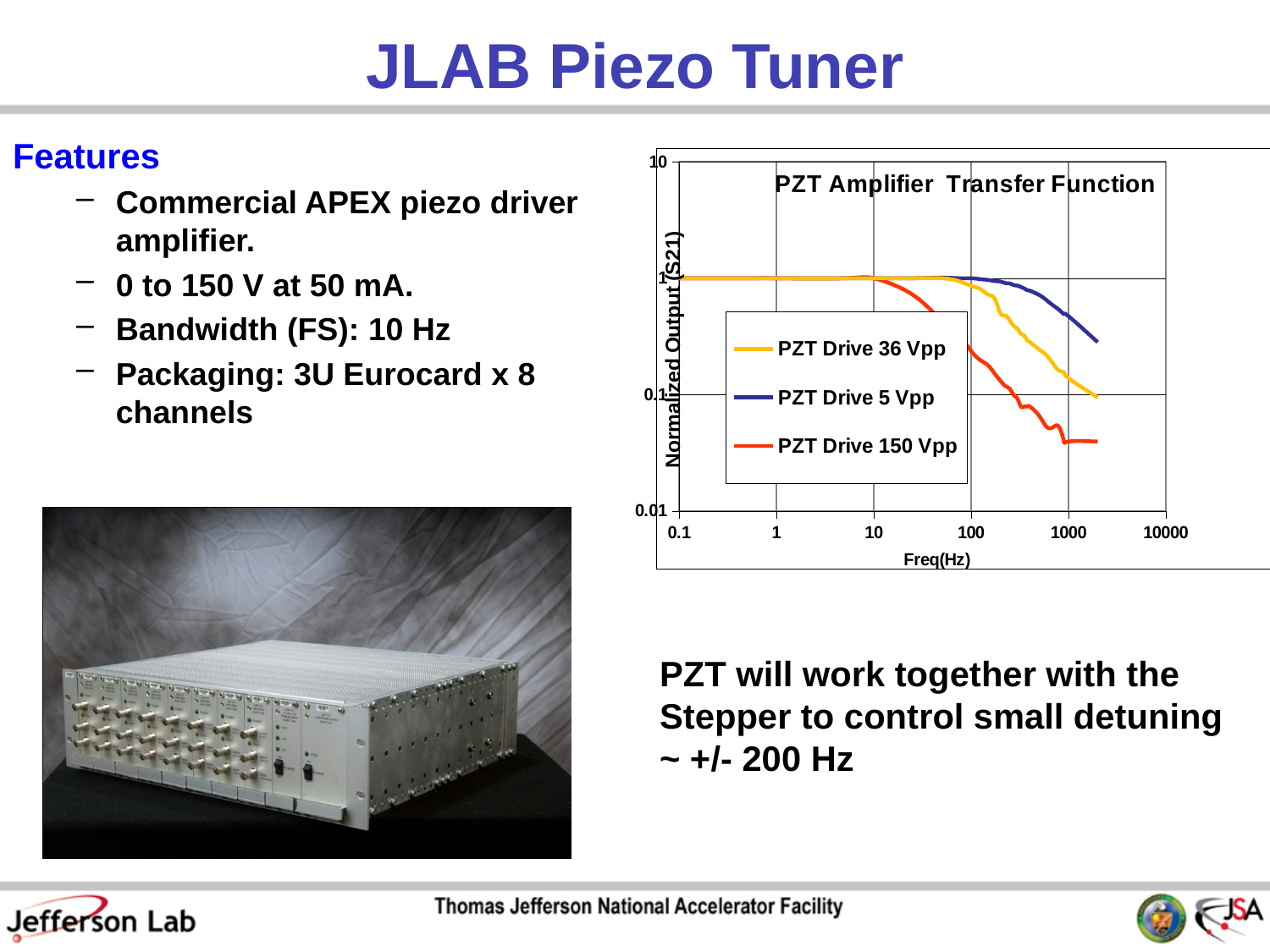
In the PZT Amplifier Transfer Function chart, which series has the higher normalized output at 1000 Hz, PZT Drive 36 Vpp or PZT Drive 150 Vpp? PZT Drive 36 Vpp In the PZT Amplifier Transfer Function chart, which series has the lowest normalized output at 1000 Hz? PZT Drive 150 Vpp What is the label of the x axis of the PZT Amplifier Transfer Function chart? Freq(Hz) What is the title of the chart on the slide? PZT Amplifier Transfer Function How many series does the legend of the PZT Amplifier Transfer Function chart list? 3 In the PZT Amplifier Transfer Function chart, which series has the higher normalized output at 1000 Hz, PZT Drive 5 Vpp or PZT Drive 150 Vpp? PZT Drive 5 Vpp In the PZT Amplifier Transfer Function chart, do the normalized output values rise or fall as frequency increases beyond about 10 Hz? fall In the PZT Amplifier Transfer Function chart, is the normalized output for PZT Drive 150 Vpp at 1000 Hz greater or less than 0.1? less What kind of chart is the PZT Amplifier Transfer Function chart? line chart In the PZT Amplifier Transfer Function chart, is the normalized output for PZT Drive 5 Vpp at 1000 Hz greater or less than 0.1? greater In the PZT Amplifier Transfer Function chart, is the normalized output for PZT Drive 150 Vpp at 100 Hz greater or less than 0.1? greater In the PZT Amplifier Transfer Function chart, which series has the highest normalized output at 1000 Hz? PZT Drive 5 Vpp